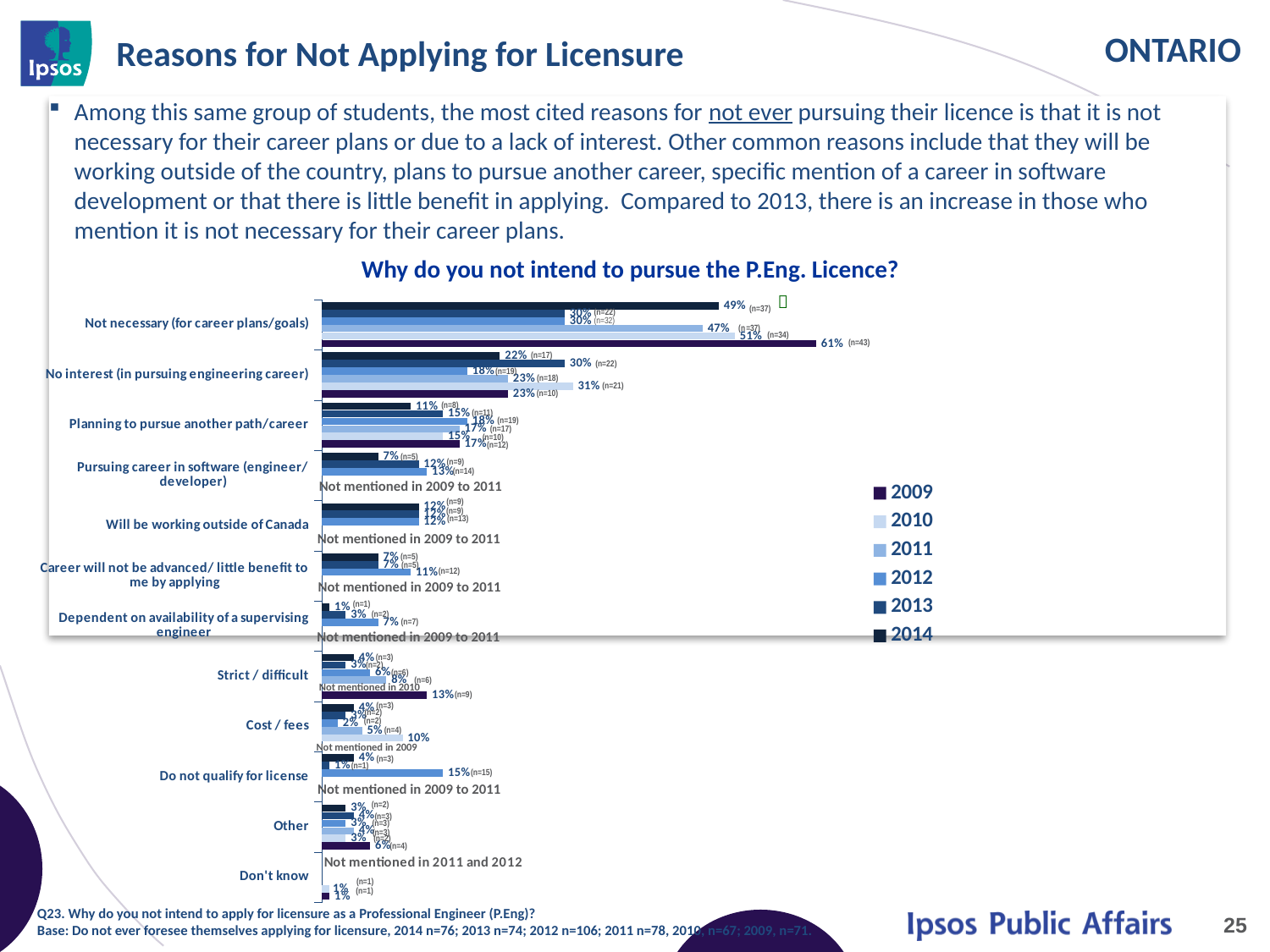
What is the 2013 value for "No interest (in pursuing engineering career)"? 30% What is the 2014 value for "No interest (in pursuing engineering career)"? 22% What is the title of the chart? Why do you not intend to pursue the P.Eng. Licence? What is the 2014 value for "Planning to pursue another path/career"? 11% For 2014, which is larger: "Not necessary (for career plans/goals)" or "No interest (in pursuing engineering career)"? Not necessary (for career plans/goals) What is the difference between the 2009 and 2014 values for "Not necessary (for career plans/goals)"? 12 percentage points What kind of chart is shown on the slide? Bar chart What is the 2012 value for "Do not qualify for license"? 15% What is the 2009 value for "Not necessary (for career plans/goals)"? 61% How many series does the chart legend list? 6 Which reason has the highest 2014 value? Not necessary (for career plans/goals) What is the 2014 value for "Not necessary (for career plans/goals)"? 49%